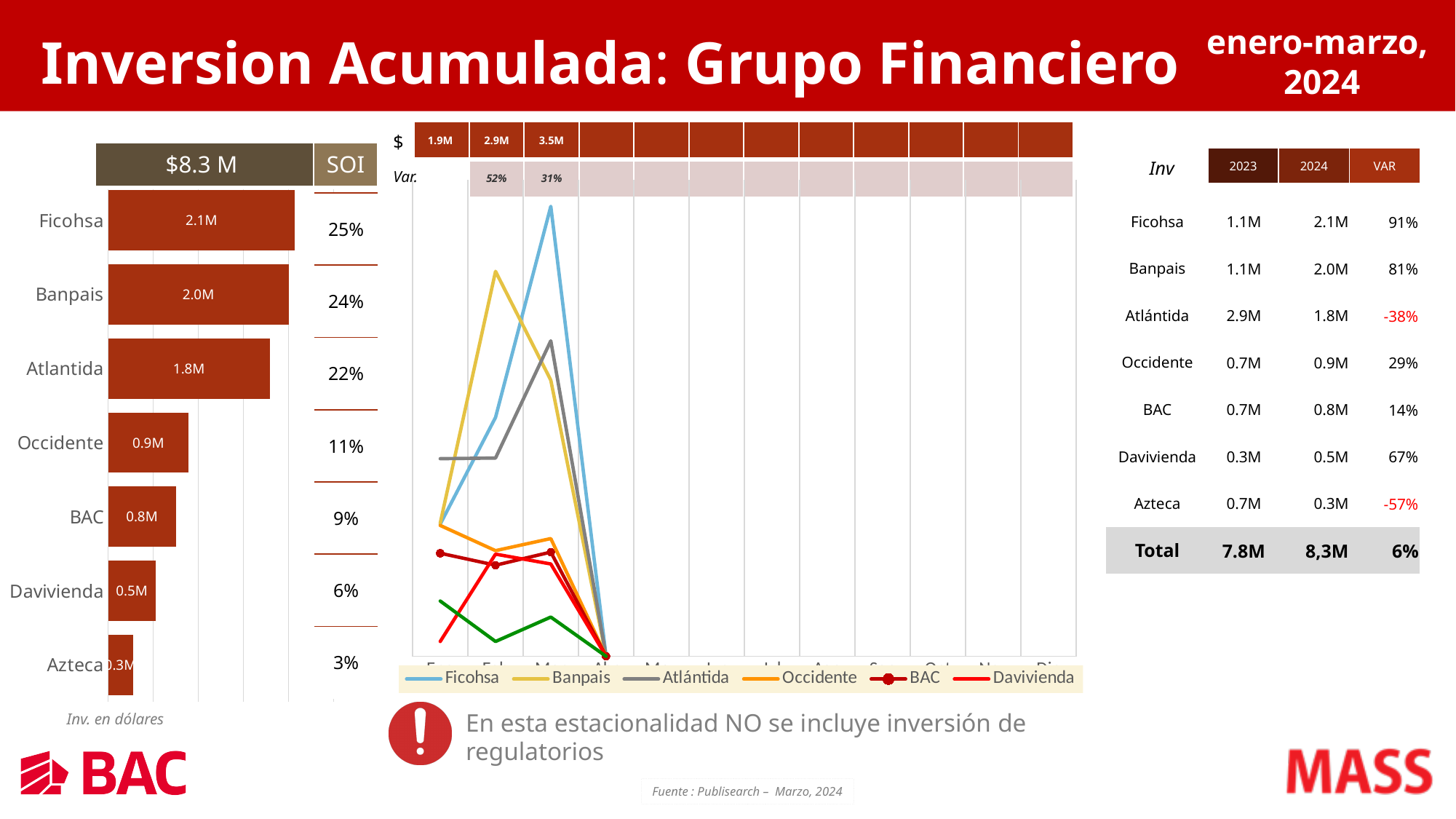
How many groups (bars) are shown in the bar chart on the left? 7 What kind of chart is the chart on the left of the slide? Bar chart What SOI percentage is shown next to Banpais in the bar chart on the left? 24% In the line chart in the middle, what is the monthly total ($) shown above the chart for March? 3.5M In the bar chart on the left, which is larger, the value for Occidente or the value for BAC? Occidente In the bar chart on the left, which group has the lowest accumulated investment? Azteca In the line chart in the middle, which series reaches the highest point in March? Ficohsa How many series does the legend of the line chart in the middle list? 6 In the bar chart on the left, what is the accumulated investment value shown for Ficohsa? 2.1M In the bar chart on the left, which group has the highest accumulated investment? Ficohsa In the bar chart on the left, what is the difference between the values for Ficohsa and Atlantida? 0.3M In the bar chart on the left, what is the value shown for Davivienda? 0.5M